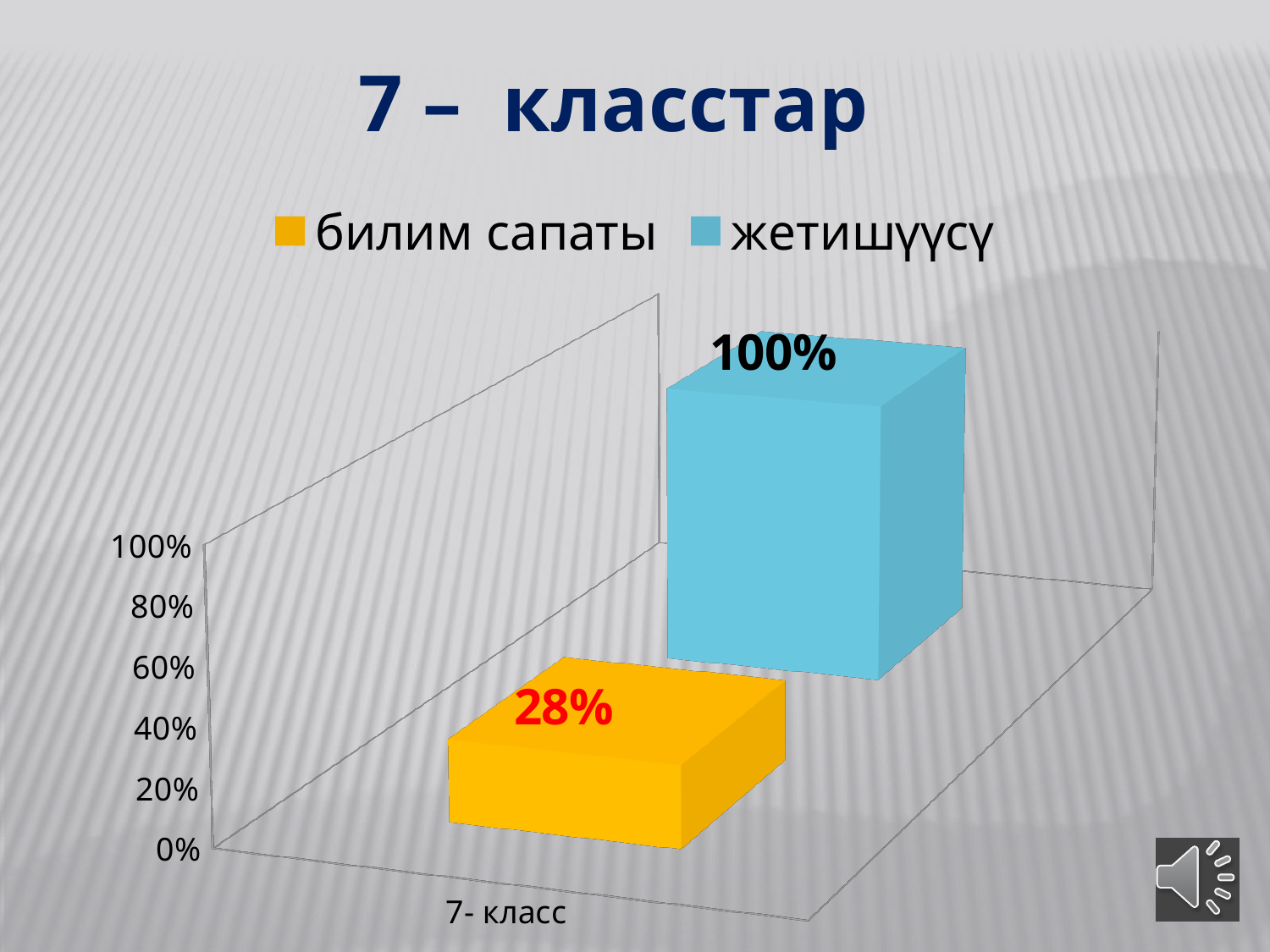
What colour is the bar for жетишүүсү? blue How many categories are shown on the x axis? 1 Is the value for жетишүүсү greater or less than 80%? greater What is the value for жетишүүсү for 7- класс? 100% Is the value for билим сапаты greater or less than 40%? less Which series has the lowest value on the chart? билим сапаты What kind of chart is shown on the slide? bar chart Which series has the higher value for 7- класс, билим сапаты or жетишүүсү? жетишүүсү How many series does the legend list? 2 What is the value for билим сапаты for 7- класс? 28% What is the title of the slide? 7 – класстар What is the difference between the жетишүүсү and билим сапаты values for 7- класс? 72%